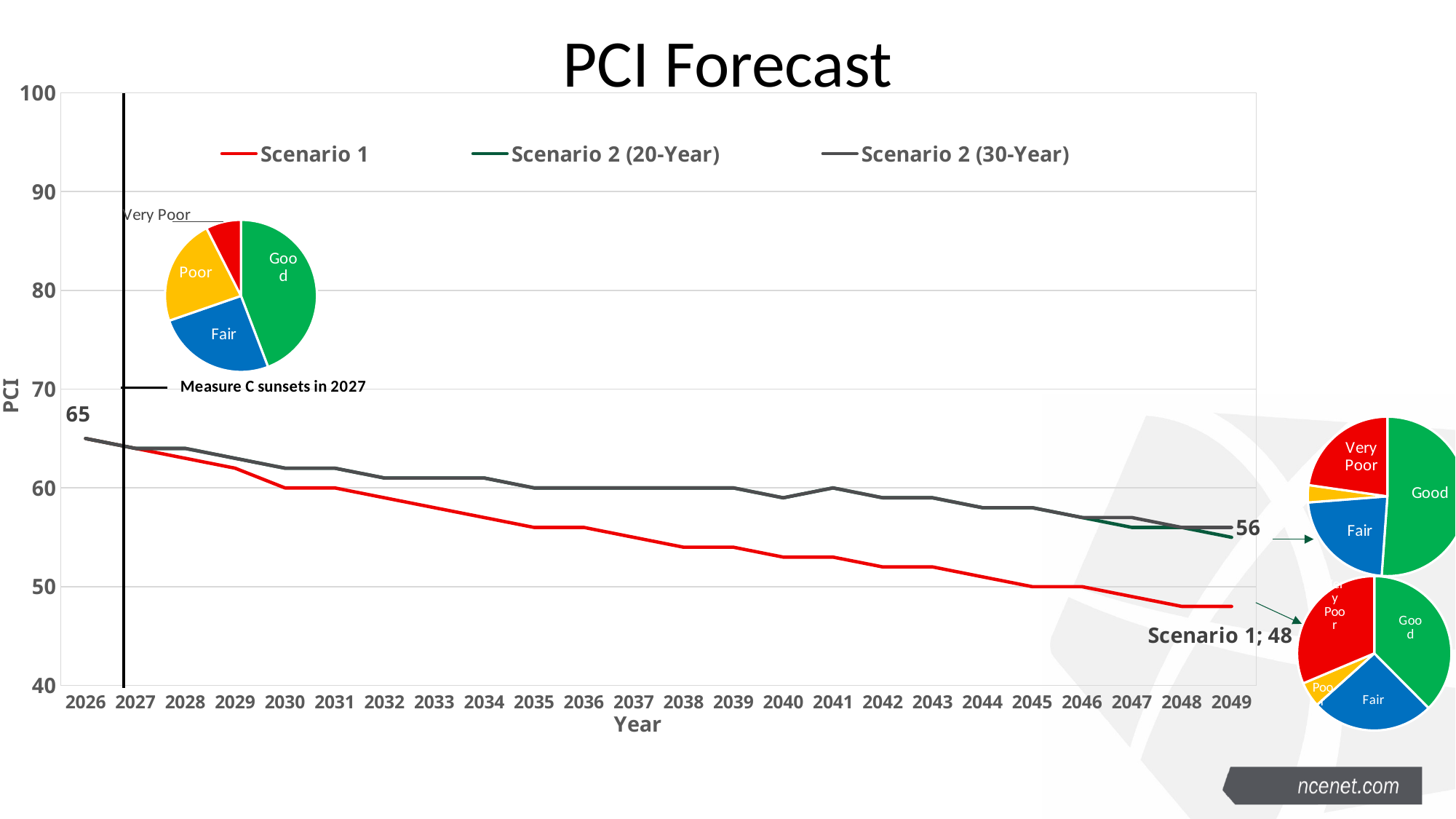
In the PCI Forecast line chart, what colour is the Scenario 1 line? red In the PCI Forecast line chart, how many series does the legend list? 3 In the PCI Forecast line chart, which series has the lowest PCI value in 2049? Scenario 1 In the PCI Forecast line chart, what is the PCI value for Scenario 2 (30-Year) in 2049? 56 What kind of chart is the main PCI Forecast chart? line chart In the PCI Forecast line chart, what is the PCI value for Scenario 1 in 2049? 48 In the PCI Forecast line chart, what is the difference between the 2026 PCI value and the Scenario 1 value in 2049? 17 In the PCI Forecast line chart, what is the PCI value in 2026? 65 In the PCI Forecast line chart, is the Scenario 1 value in 2040 greater or less than 60? less In the PCI Forecast line chart, do the PCI values rise or fall from 2026 to 2049? fall In the PCI Forecast line chart, what is the difference between the Scenario 2 (30-Year) and Scenario 1 values in 2049? 8 In the PCI Forecast line chart, how many years are shown on the x axis? 24